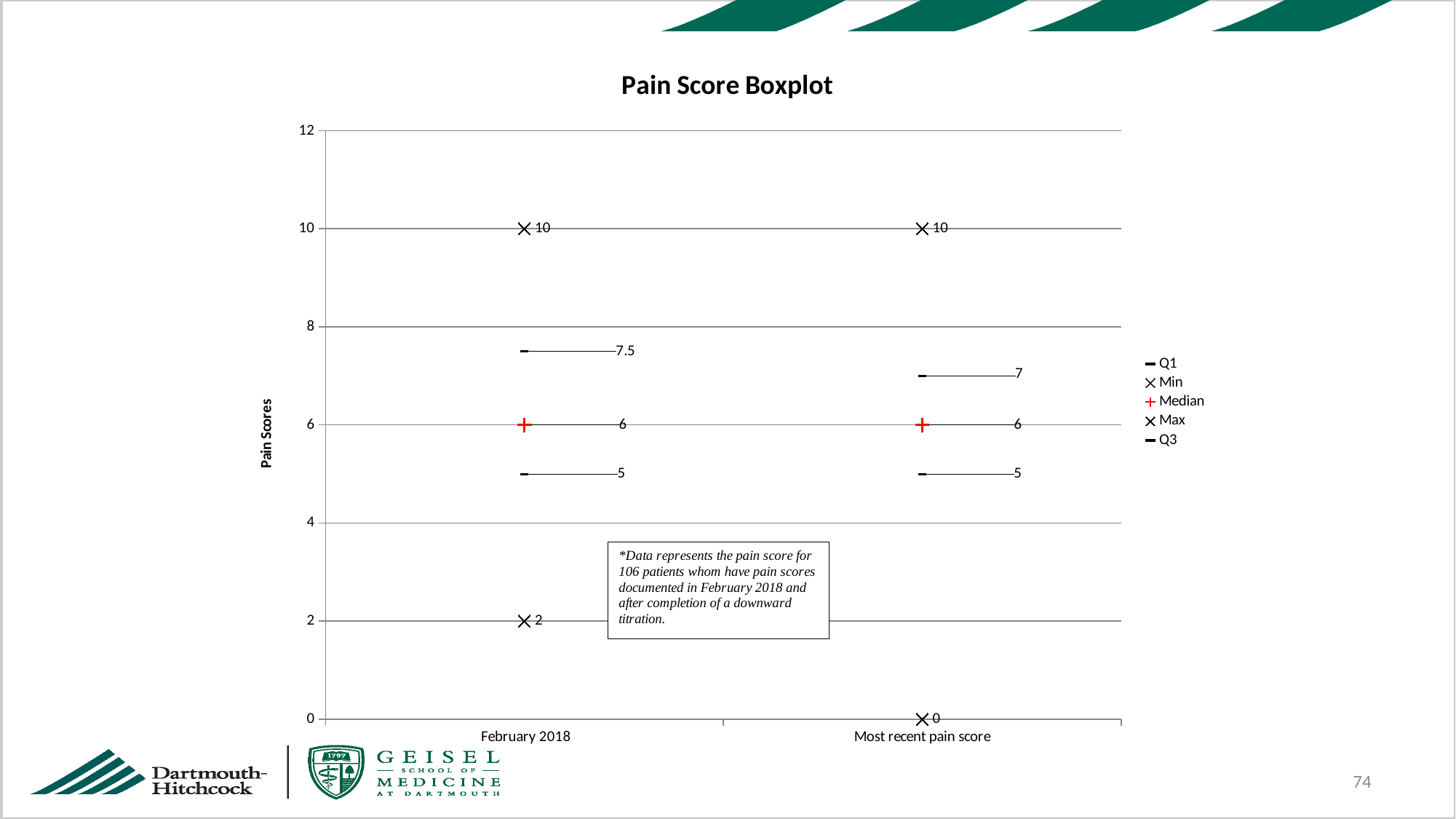
What is the difference between the Max and Min values for February 2018? 8 What is the Median value for February 2018? 6 How many categories are shown on the x axis? 2 What is the Q3 value for February 2018? 7.5 What is the Q1 value for Most recent pain score? 5 What is the difference between the Q3 value for February 2018 and the Q3 value for Most recent pain score? 0.5 What is the Max value for Most recent pain score? 10 What is the Min value for Most recent pain score? 0 What is the title of the chart? Pain Score Boxplot Which category has the higher Min value, February 2018 or Most recent pain score? February 2018 What is the label of the y axis? Pain Scores How many series does the legend list? 5